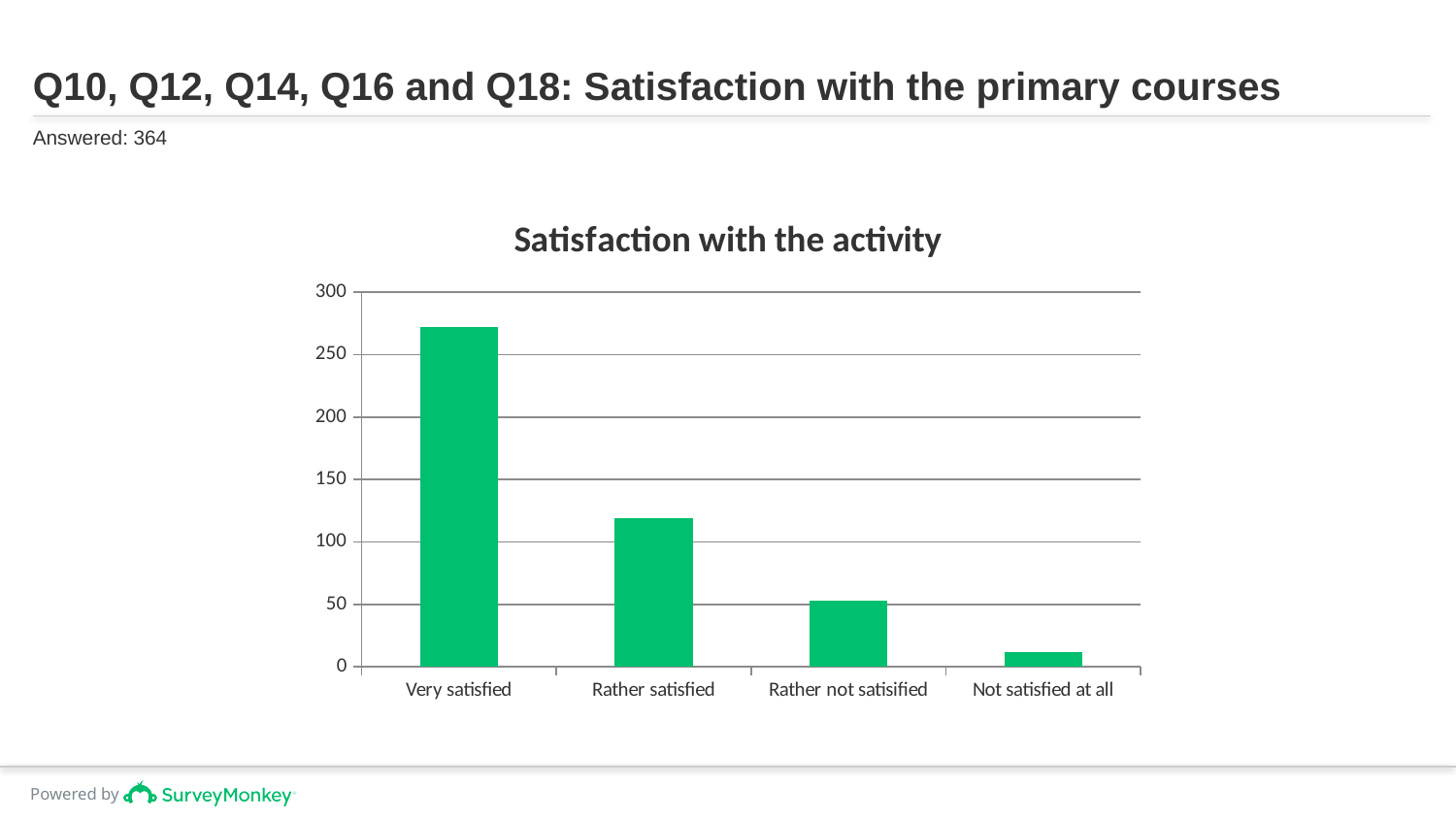
Which is larger, the value for Rather satisfied or the value for Rather not satisified? Rather satisfied Is the value for Not satisfied at all greater or less than 50? less What is the highest value shown on the y axis of the chart? 300 Is the value for Rather satisfied greater or less than 100? greater What type of chart is shown on the slide? bar chart How many categories are shown on the x axis of the chart? 4 Which category has the highest value? Very satisfied Which category has the lowest value? Not satisfied at all Is the value for Very satisfied greater or less than 250? greater Do the values rise or fall from left to right along the x axis? fall What is the title of the chart? Satisfaction with the activity